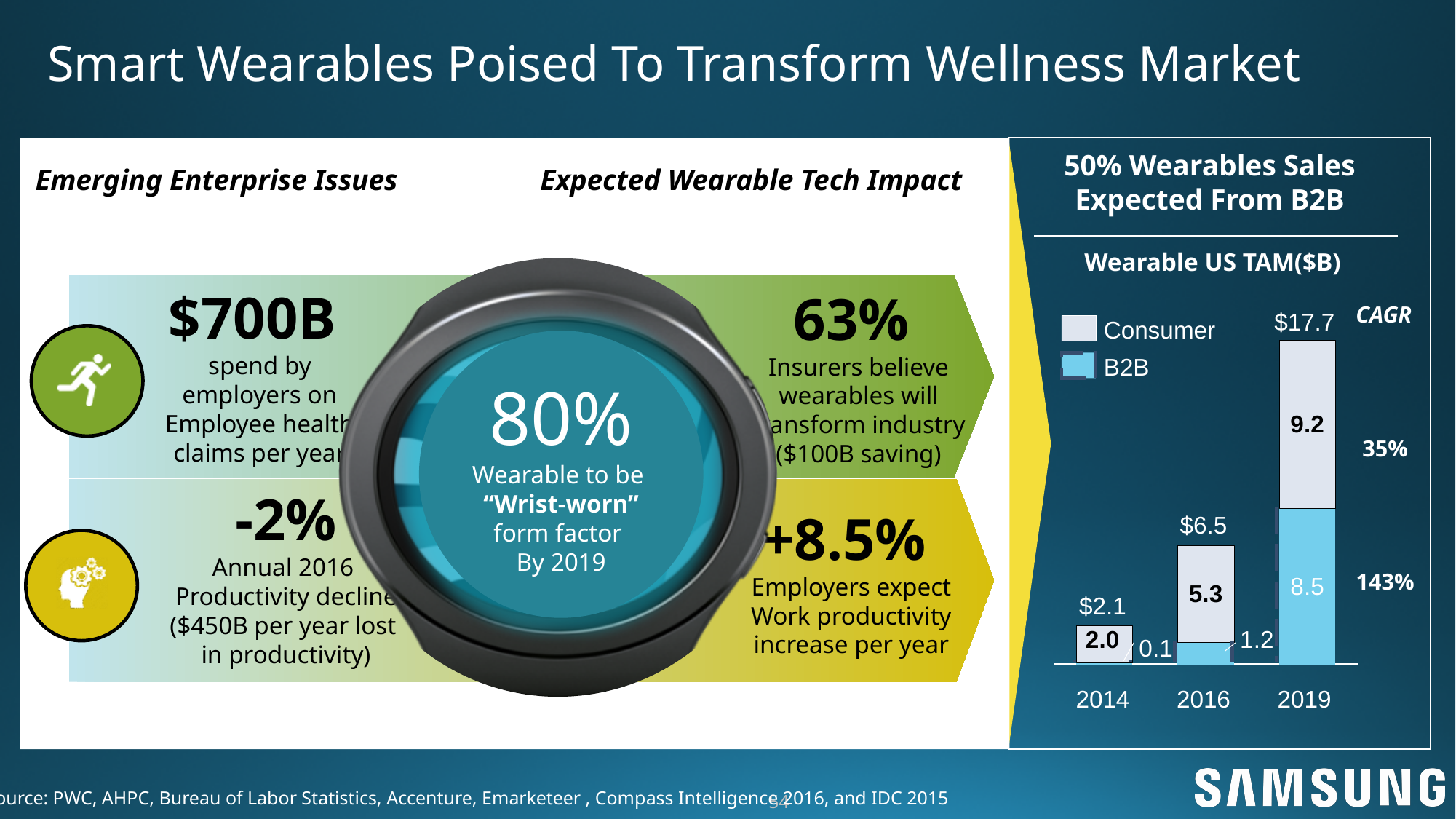
What is the difference between the Consumer values for 2019 and 2016 in the Wearable US TAM chart? 3.9 What is the total Wearable US TAM shown for 2014? $2.1 What is the B2B value for 2016 in the Wearable US TAM($B) chart? 1.2 In 2019, which is larger in the Wearable US TAM chart: Consumer or B2B? Consumer How many series does the legend of the Wearable US TAM chart list? 2 What CAGR is shown for the B2B series in the Wearable US TAM chart? 143% What kind of chart is the Wearable US TAM($B) chart? Stacked bar chart What is the total Wearable US TAM shown for 2019? $17.7 Which year has the lowest B2B value in the Wearable US TAM chart? 2014 How many years are shown on the x axis of the Wearable US TAM chart? 3 What is the Consumer value for 2019 in the Wearable US TAM($B) chart? 9.2 Which year has the highest total Wearable US TAM? 2019